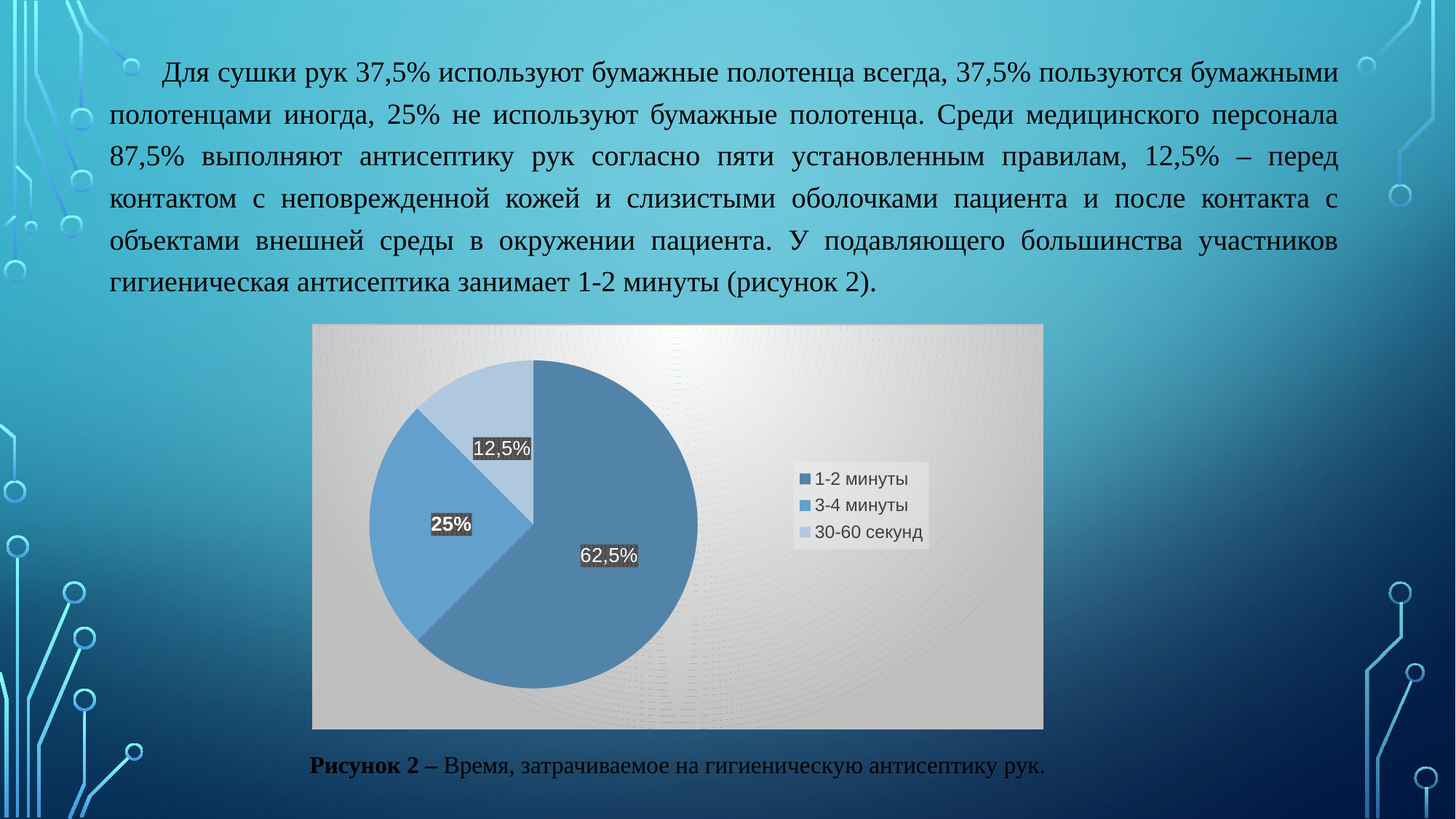
Which slice is larger: "3-4 минуты" or "30-60 секунд"? 3-4 минуты What is the difference in percentage points between the "1-2 минуты" slice and the "3-4 минуты" slice? 37,5 What share of the pie chart corresponds to "3-4 минуты"? 25% How many slices does the pie chart have? 3 What share of the pie chart corresponds to "1-2 минуты"? 62,5% What share of the pie chart corresponds to "30-60 секунд"? 12,5% Which category has the smallest slice in the pie chart? 30-60 секунд Which category has the largest slice in the pie chart? 1-2 минуты What type of chart is shown on the slide? pie chart Which legend entry is shown in the lightest blue colour? 30-60 секунд What is the caption of the figure below the pie chart? Рисунок 2 – Время, затрачиваемое на гигиеническую антисептику рук. How many entries does the legend of the pie chart list? 3